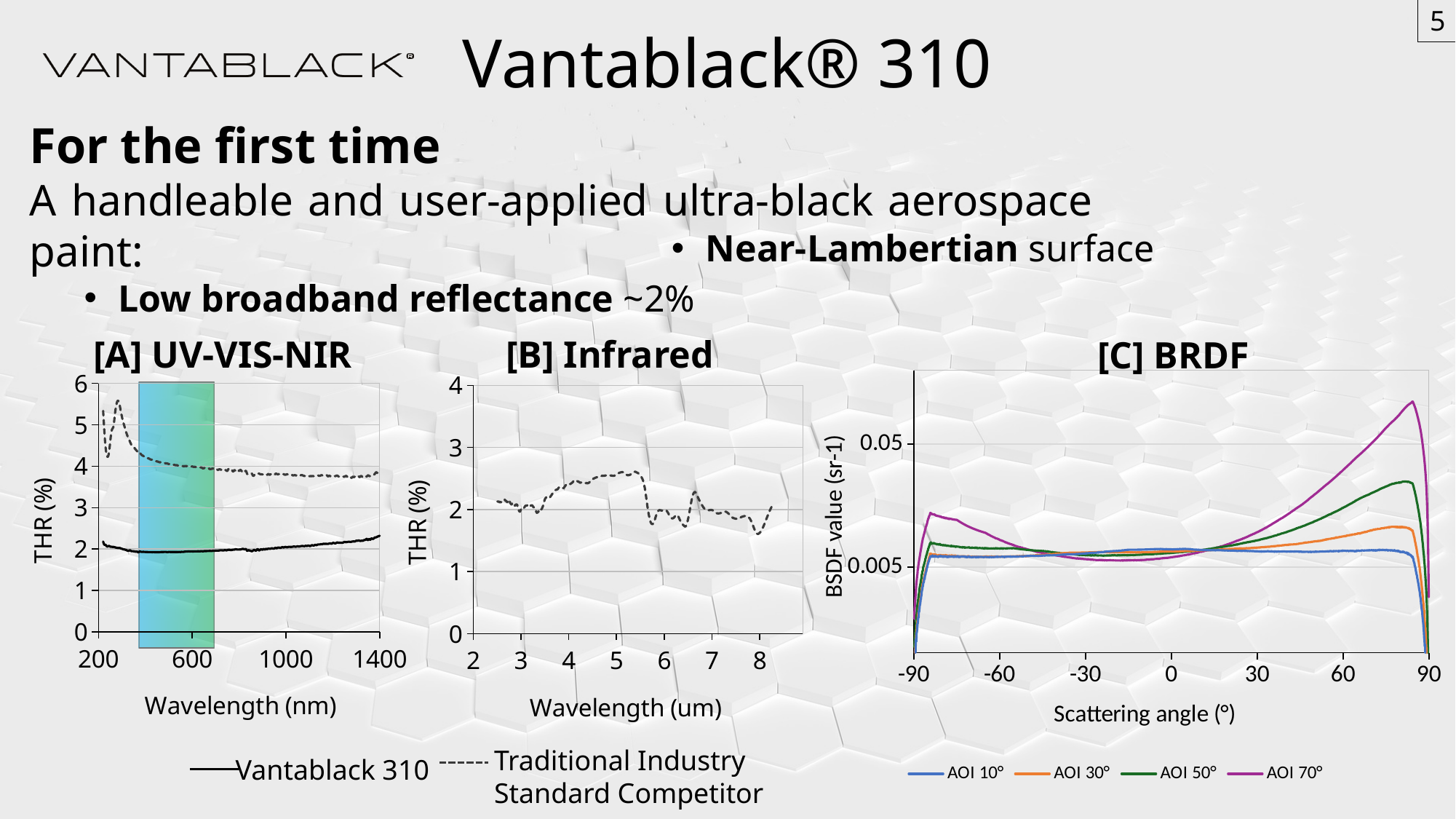
In the [C] BRDF chart, how many series does the legend list? 4 How many charts are shown on the slide? 3 In the [C] BRDF chart, is the AOI 70° value at a scattering angle of 60° greater or less than 0.005? greater In the [C] BRDF chart, which series reaches the highest BSDF value? AOI 70° In the [C] BRDF chart, does the AOI 70° series rise or fall between scattering angles of 0° and 60°? rise What is the x-axis label of the [C] BRDF chart? Scattering angle (°) In the [B] Infrared chart, is the THR value at 5 um greater or less than 2? greater In the [A] UV-VIS-NIR chart, which series is drawn as a dashed line? Traditional Industry Standard Competitor In the [A] UV-VIS-NIR chart, which series has the higher THR at 600 nm, Vantablack 310 or the Traditional Industry Standard Competitor? Traditional Industry Standard Competitor In the [A] UV-VIS-NIR chart, is the Vantablack 310 value at 1000 nm greater or less than 3? less What kind of chart is the [A] UV-VIS-NIR chart? line chart